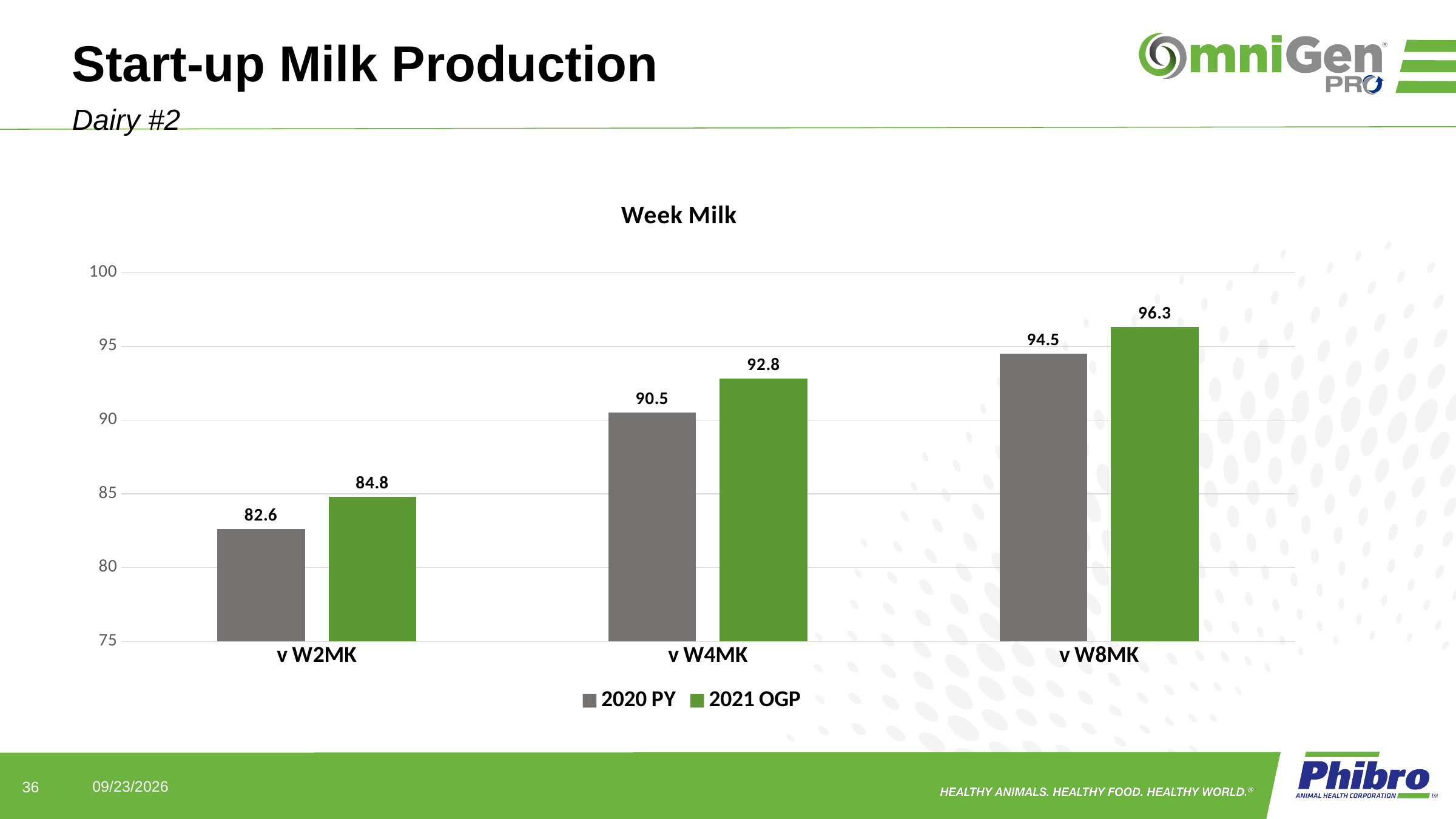
What is the 2021 OGP value for v W4MK? 92.8 What is the difference between the 2021 OGP and 2020 PY values for v W8MK? 1.8 How many categories are shown on the x axis? 3 Which category has the highest 2021 OGP value? v W8MK How many series does the legend list? 2 What is the difference between the 2021 OGP and 2020 PY values for v W4MK? 2.3 What is the 2020 PY value for v W2MK? 82.6 Which category has the lowest 2020 PY value? v W2MK What is the 2020 PY value for v W8MK? 94.5 Which is larger for v W2MK, the 2020 PY value or the 2021 OGP value? 2021 OGP What kind of chart is shown on the slide? Bar chart Is the 2020 PY value for v W4MK greater or less than 90? greater